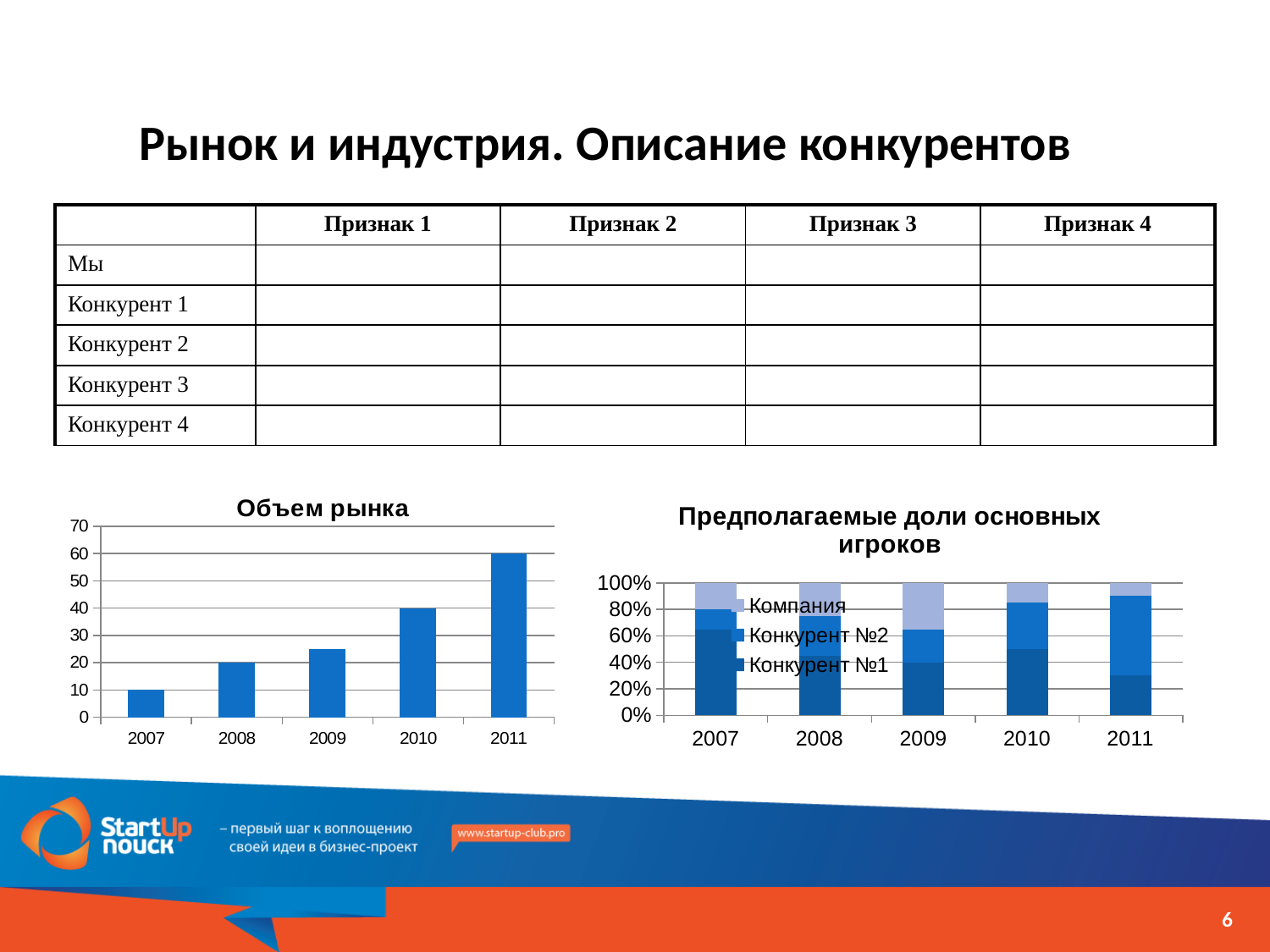
In the chart titled "Объем рынка", do the values rise or fall from 2007 to 2011? rise In the chart titled "Объем рынка", is the value for 2009 greater or less than 30? less In the chart titled "Объем рынка", what is the value for 2011? 60 In the chart titled "Объем рынка", what is the value for 2010? 40 In the chart titled "Объем рынка", what is the value for 2007? 10 In the chart titled "Объем рынка", which year has the highest value? 2011 In the chart titled "Объем рынка", how many years are shown on the x axis? 5 In the chart titled "Предполагаемые доли основных игроков", is the share of Конкурент №1 in 2011 greater or less than 40%? less In the chart titled "Предполагаемые доли основных игроков", how many series does the legend list? 3 In the chart titled "Объем рынка", what is the difference between the values for 2011 and 2007? 50 What kind of chart is the chart titled "Предполагаемые доли основных игроков"? stacked bar chart In the chart titled "Объем рынка", which year has the lowest value? 2007